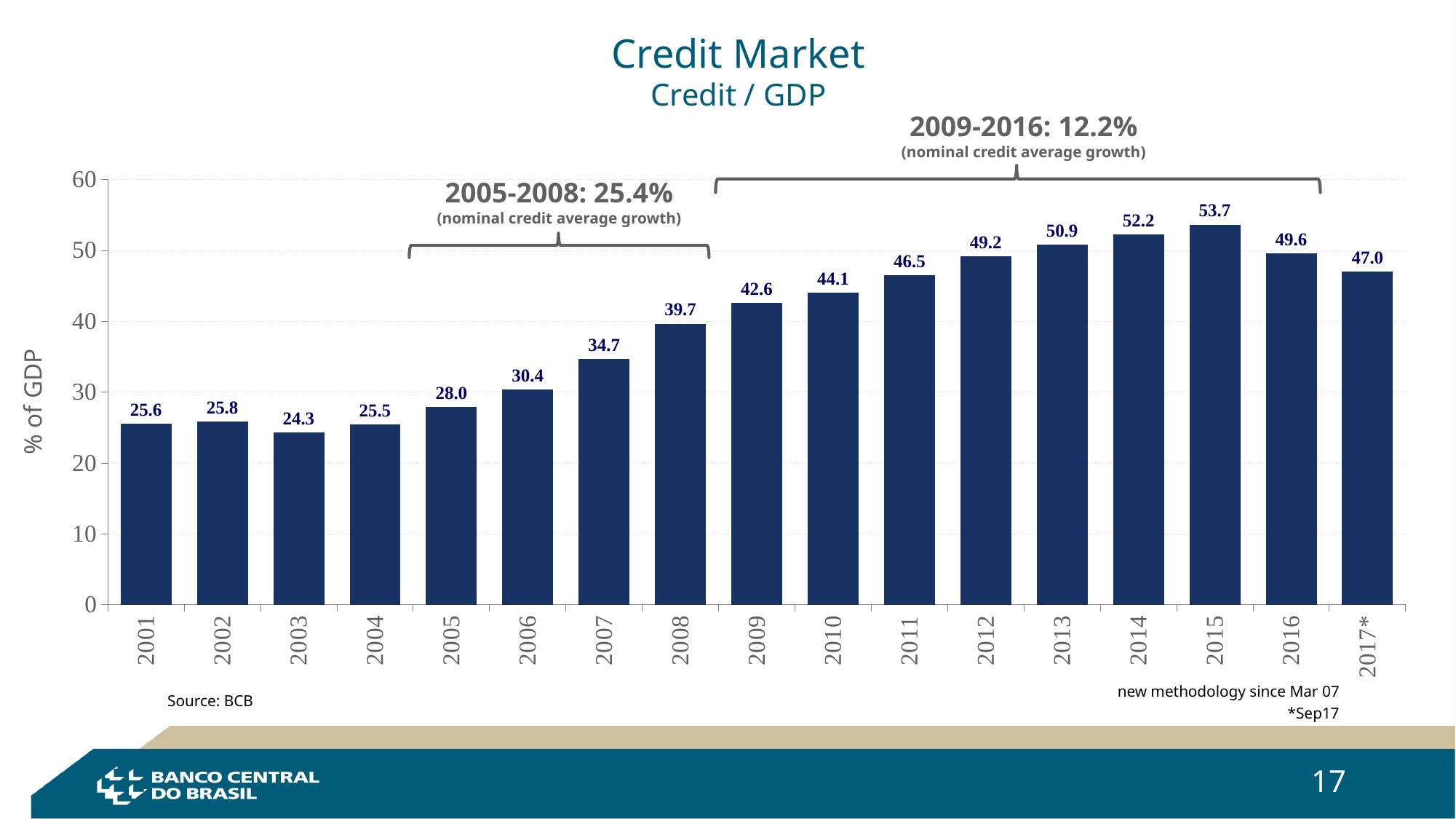
What kind of chart is shown on the slide? bar chart How many years are shown on the x axis? 17 What is the difference between the 2015 value and the 2016 value? 4.1 Which is larger, the value for 2009 or the value for 2010? 2010 What is the label on the y axis? % of GDP What is the credit-to-GDP value for 2017*? 47.0 Which year has the highest credit-to-GDP value? 2015 Do the values rise or fall from 2004 to 2015? rise What is the nominal credit average growth shown for 2005-2008? 25.4% Which year has the lowest credit-to-GDP value? 2003 What is the credit-to-GDP value for 2008? 39.7 Is the value for 2012 greater or less than 40? greater